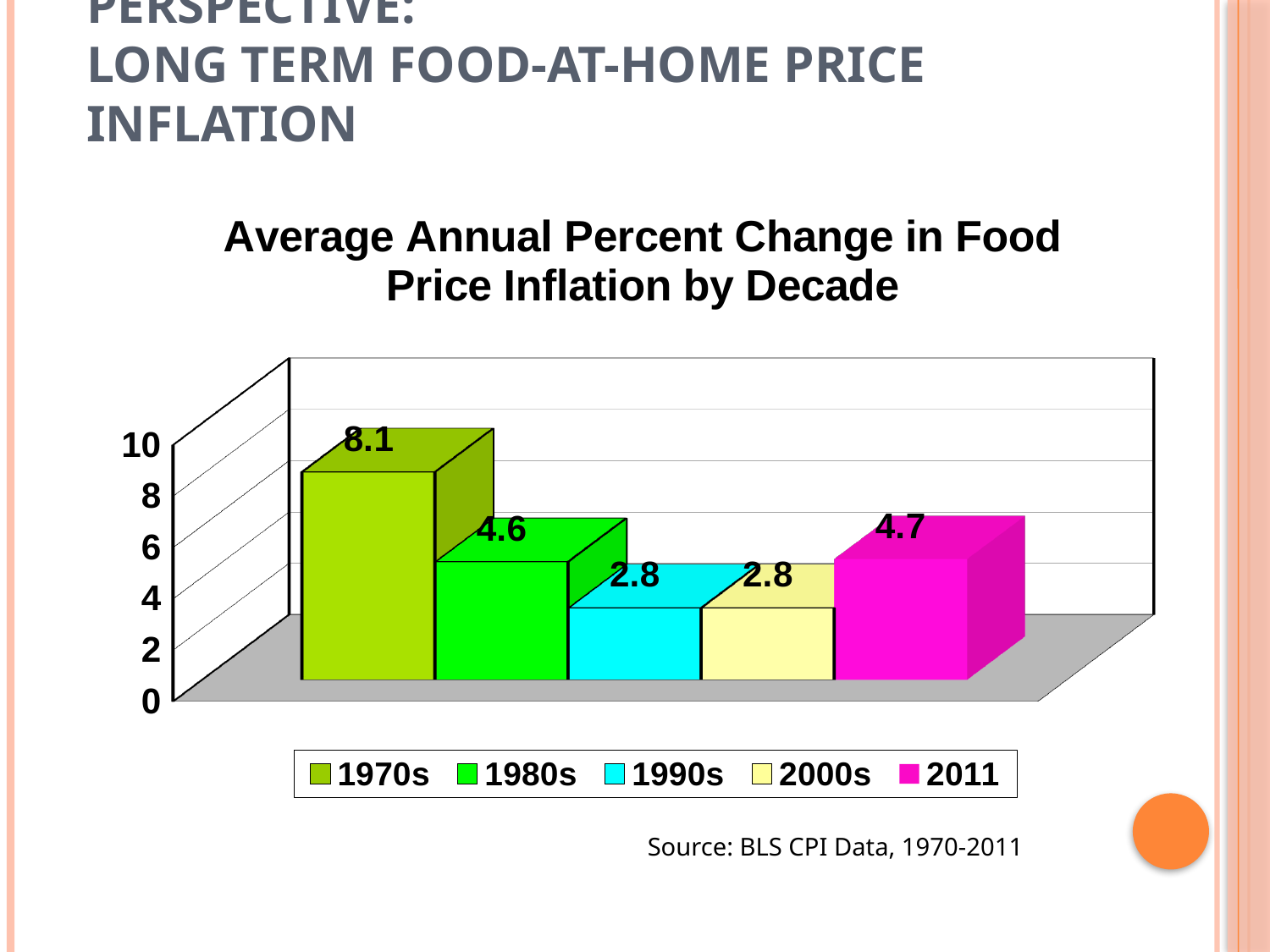
What is the difference between the 2011 value and the 2000s value? 1.9 What is the value for the 1980s? 4.6 What is the value for the 1970s? 8.1 Which is larger, the value for the 1970s or the value for 2011? 1970s Is the value for the 1970s greater or less than 6? greater What is the value for the 1990s? 2.8 What kind of chart is shown on the slide? Bar chart What is the difference between the 1970s value and the 1980s value? 3.5 What is the title of the chart? Average Annual Percent Change in Food Price Inflation by Decade How many bars are shown in the chart? 5 What is the value for 2011? 4.7 Which decade has the highest average annual percent change? 1970s